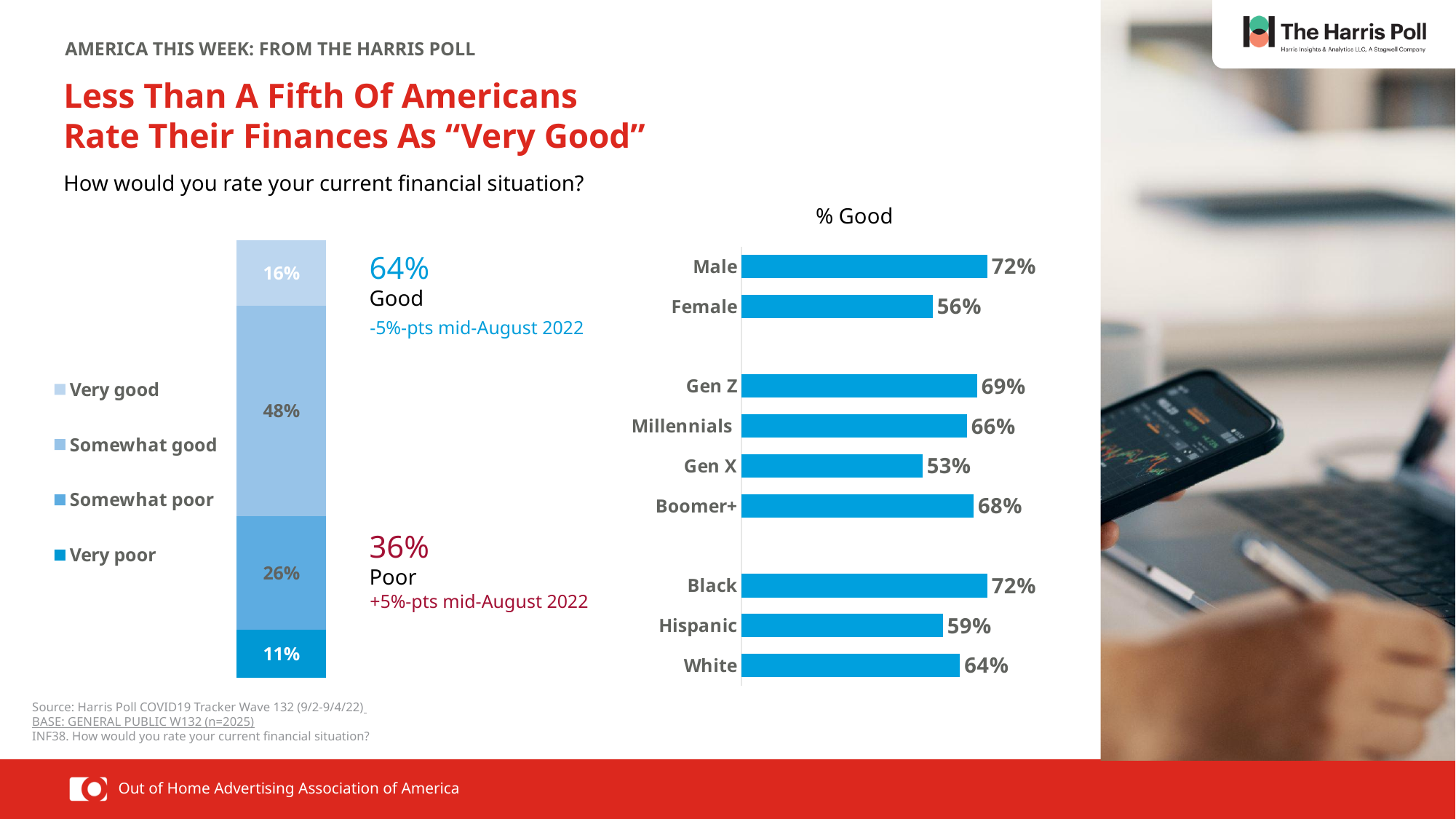
In the "% Good" chart on the right, which is higher, Hispanic or White? White In the "% Good" chart on the right, how many groups are shown? 9 In the stacked bar chart on the left, which category has the largest share? Somewhat good In the "% Good" chart on the right, what is the value for Female? 56% In the stacked bar chart on the left, what percentage rated their finances as "Very poor"? 11% In the stacked bar chart on the left, what percentage rated their finances as "Somewhat good"? 48% In the "% Good" chart on the right, what is the difference between Male and Female? 16 percentage points In the stacked bar chart on the left, how many entries does the legend list? 4 In the "% Good" chart on the right, what is the value for Boomer+? 68% In the stacked bar chart on the left, what percentage rated their finances as "Very good"? 16% What type of chart is the "% Good" chart on the right? Bar chart In the "% Good" chart on the right, which group has the lowest value? Gen X